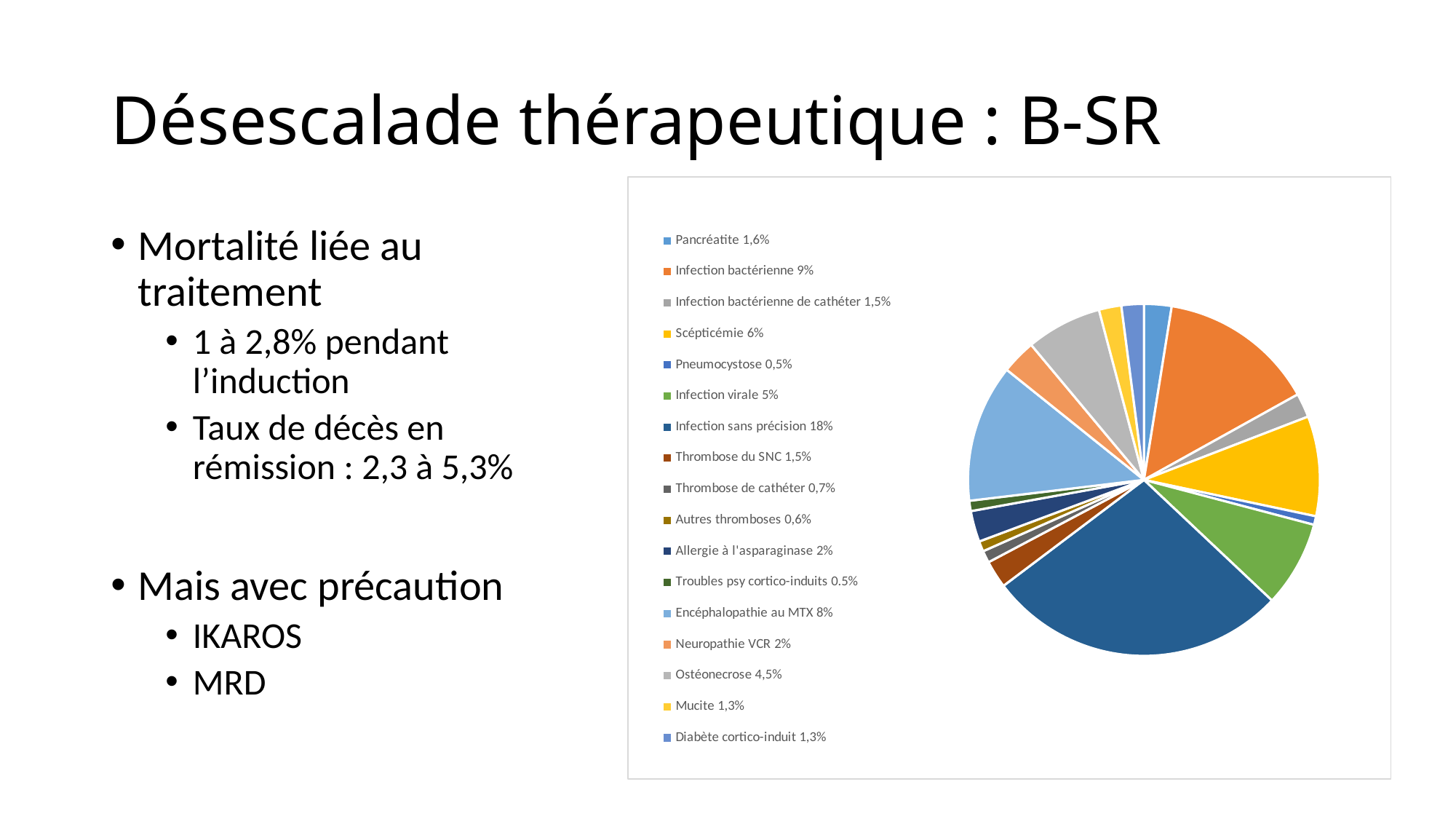
What value is given for Encéphalopathie au MTX in the legend? 8% Which category has the largest slice in the pie chart? Infection sans précision 18% Which is larger, the value for Infection bactérienne or the value for Scépticémie? Infection bactérienne What value is given for Allergie à l'asparaginase in the legend? 2% How many categories does the pie chart's legend list? 17 What value is given for Infection bactérienne in the legend? 9% Which is larger, the value for Encéphalopathie au MTX or the value for Ostéonecrose? Encéphalopathie au MTX What is the difference between the values for Infection sans précision and Infection bactérienne? 9% What kind of chart is shown on the slide? pie chart What is the difference between the values for Scépticémie and Infection virale? 1% What value is given for Ostéonecrose in the legend? 4,5% What value is given for Thrombose de cathéter in the legend? 0,7%